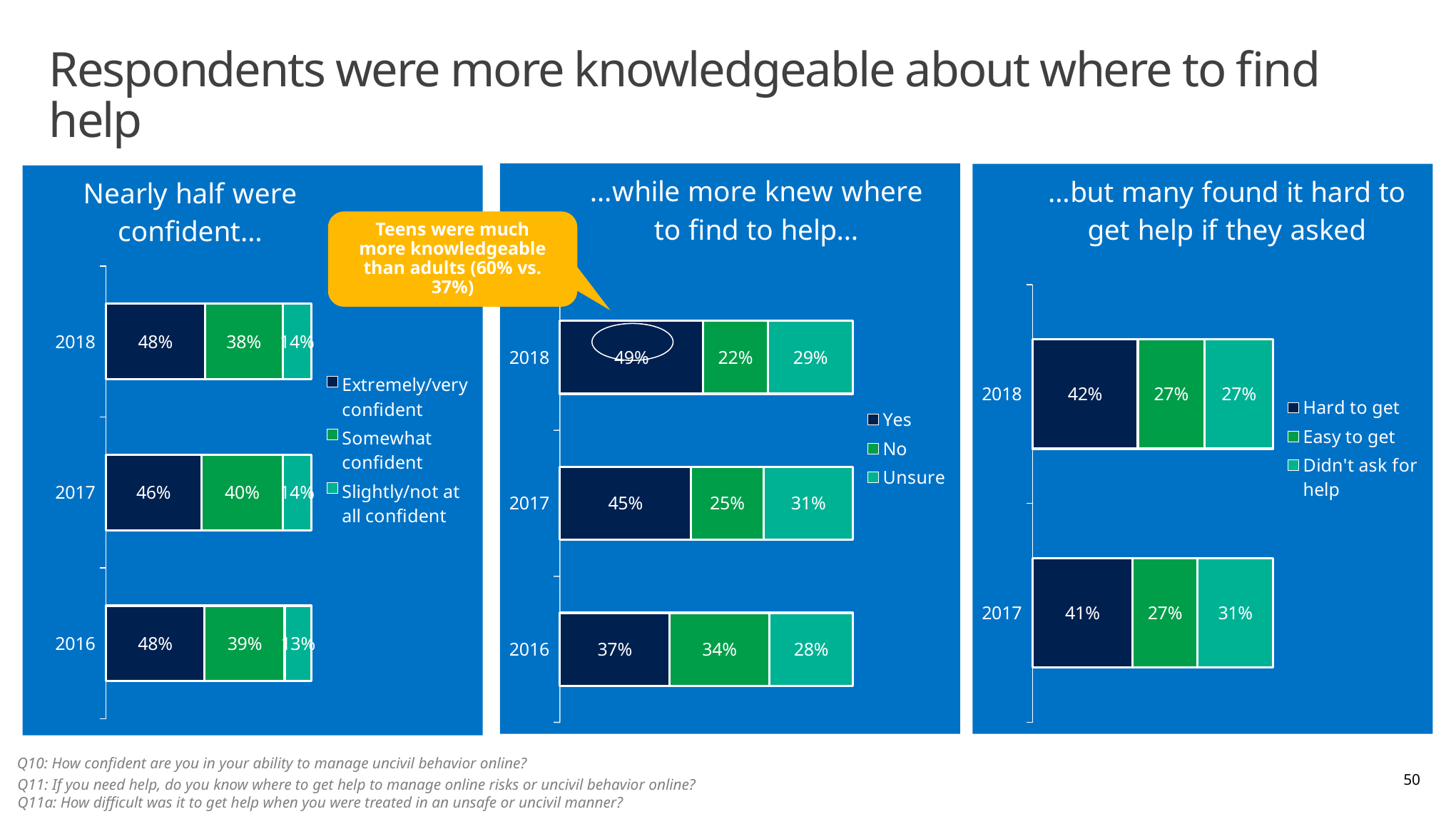
In the right chart, which is larger: the Didn't ask for help share in 2017 or in 2018? 2017 What type of chart is the middle chart? Stacked bar chart In the middle chart, does the Yes percentage rise or fall from 2016 to 2018? Rise How many series does the legend of the left chart list? 3 What are the legend entries of the middle chart? Yes, No, Unsure In the left chart ("Nearly half were confident..."), what percentage were Somewhat confident in 2017? 40% In the right chart ("...but many found it hard to get help if they asked"), what percentage said help was Hard to get in 2017? 41% In the middle chart, which year has the highest Yes percentage? 2018 In the middle chart ("...while more knew where to find to help..."), what percentage answered Yes in 2018? 49% In the middle chart, which year has the lowest Yes percentage? 2016 In the middle chart, what is the difference between the Yes percentage in 2018 and in 2016? 12 percentage points How many years are shown in the right chart? 2